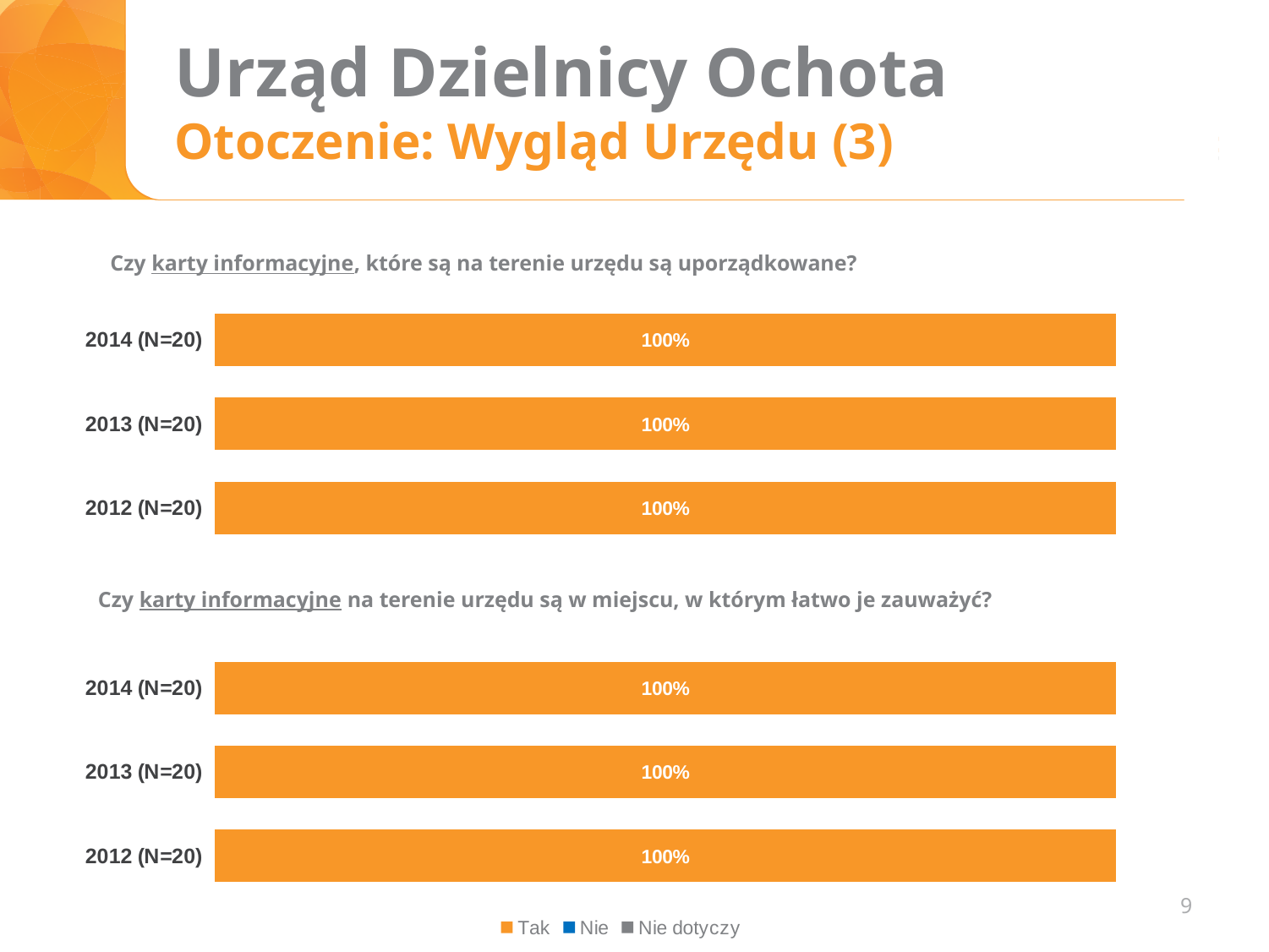
What kind of chart is the top chart? Bar chart In the top chart, what is the difference between the "Tak" value for 2014 (N=20) and 2012 (N=20)? 0% In the top chart ("Czy karty informacyjne, które są na terenie urzędu są uporządkowane?"), what is the value for "Tak" in 2014 (N=20)? 100% What are the three legend entries listed at the bottom of the slide? Tak, Nie, Nie dotyczy In the bottom chart, do the "Tak" values change between 2012 (N=20) and 2014 (N=20)? No, they stay at 100% In the bottom chart, how many year categories are shown? 3 How many series does the legend at the bottom of the slide list? 3 In the top chart, how many year categories are shown? 3 What is the sample size (N) shown for each year in the top chart? N=20 In the top chart ("Czy karty informacyjne, które są na terenie urzędu są uporządkowane?"), what is the value for "Tak" in 2012 (N=20)? 100% In the bottom chart ("Czy karty informacyjne na terenie urzędu są w miejscu, w którym łatwo je zauważyć?"), what is the value for "Tak" in 2013 (N=20)? 100% In the bottom chart ("Czy karty informacyjne na terenie urzędu są w miejscu, w którym łatwo je zauważyć?"), what is the value for "Tak" in 2012 (N=20)? 100%